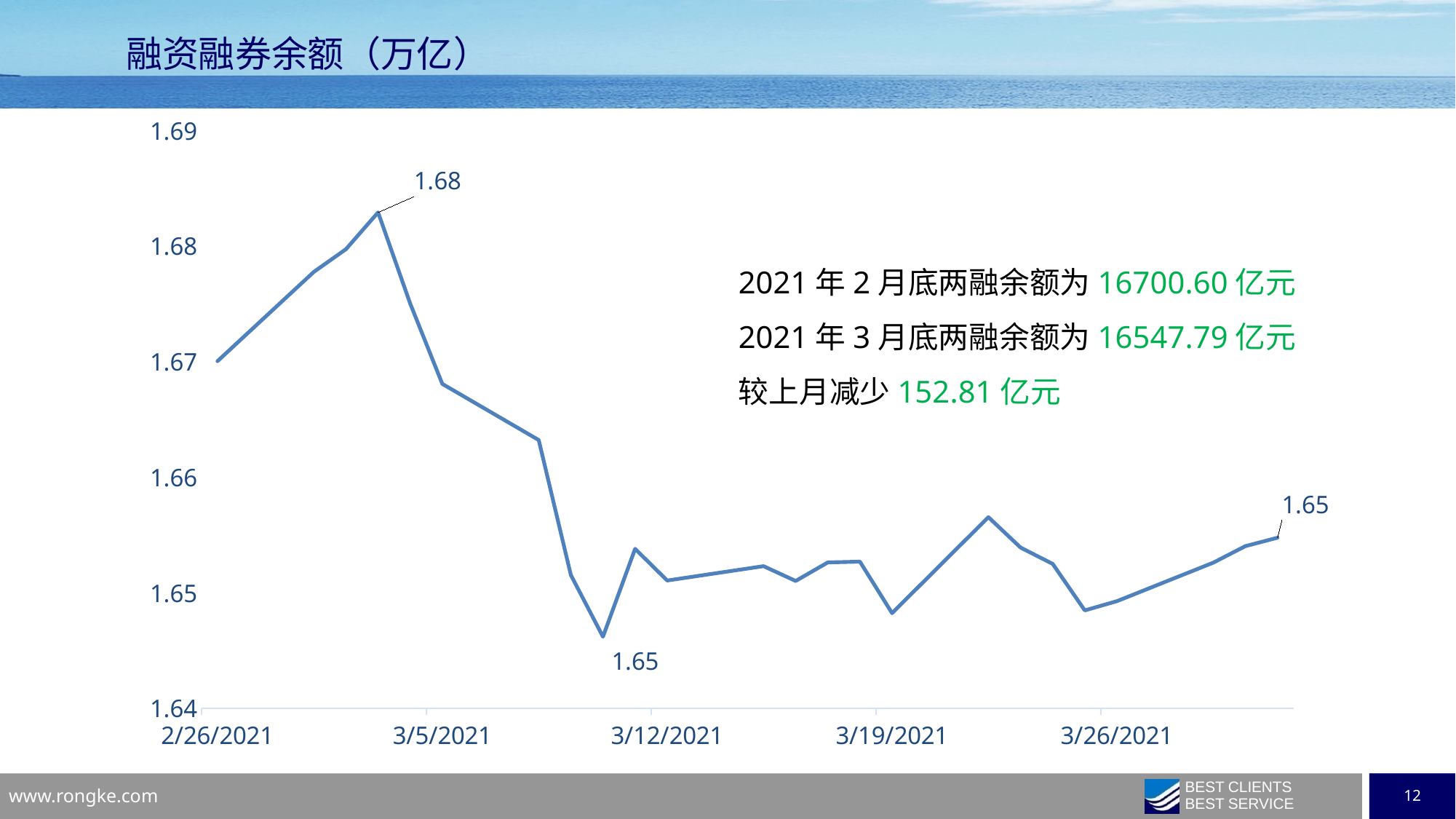
Is the value for 3/19/2021 greater or less than 1.66? less What is the highest labelled value on the line? 1.68 Which is larger, the peak value labelled 1.68 or the final value labelled 1.65? 1.68 Is the value for 2/26/2021 greater or less than 1.66? greater Is the value for 3/12/2021 greater or less than 1.66? less What is the difference between the highest labelled value (1.68) and the lowest labelled value (1.65)? 0.03 Which date has the larger value, 2/26/2021 or 3/12/2021? 2/26/2021 What is the title of the chart? 融资融券余额（万亿） According to the text on the slide, by how much did the balance decrease compared with the previous month? 152.81 亿元 Overall, does the line rise or fall from 2/26/2021 to the end of the series? fall What kind of chart is shown on the slide? line chart What is the lowest labelled value on the line? 1.65